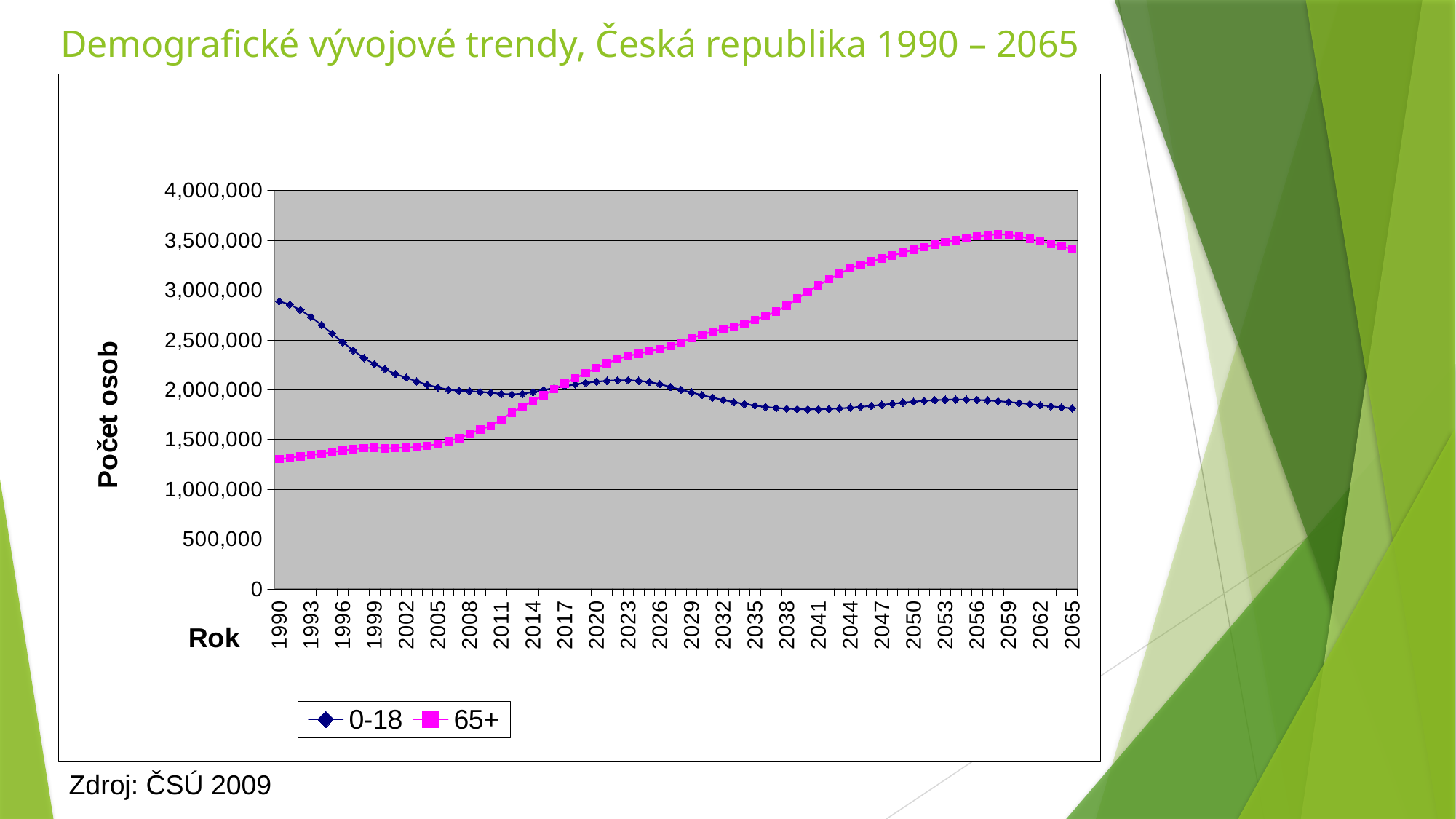
What kind of chart is shown on the slide? line chart Does the 65+ series rise or fall between 1990 and 2050? rise Is the value for the 0-18 series in 2065 greater or less than 2,000,000? less In 2065, which series has the larger value, 0-18 or 65+? 65+ Is the value for the 0-18 series in 1990 greater or less than 2,500,000? greater How many series does the legend list? 2 Is the value for the 65+ series in 1990 greater or less than 1,500,000? less In which year does the 0-18 series reach its highest value? 1990 What is the title of the chart on the slide? Demografické vývojové trendy, Česká republika 1990 – 2065 What is the label of the vertical axis? Počet osob In 1990, which series has the larger value, 0-18 or 65+? 0-18